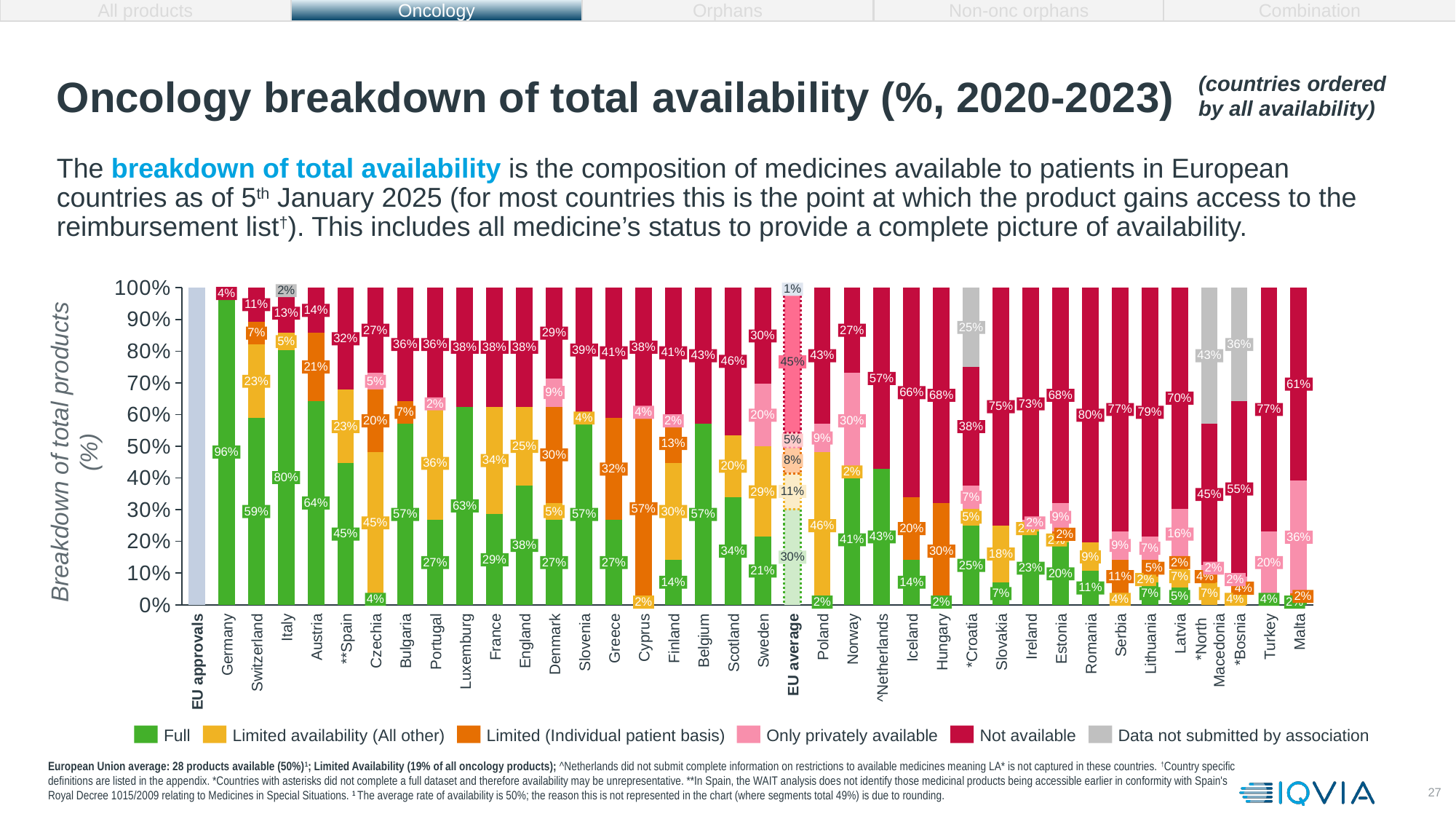
Which country has the highest 'Full' availability share? Germany What is the 'Full' availability value for Germany? 96% What kind of chart is shown on the slide? Stacked bar chart What is the 'Only privately available' value for Malta? 36% What is the 'Only privately available' value for Sweden? 20% What is the difference between the 'Full' values for Luxemburg and France? 34 percentage points What is the 'Data not submitted by association' value for *Croatia? 25% What is the 'Full' value for the EU average bar? 30% What is the 'Not available' value for Romania? 80% How many series does the legend list? 6 What colour represents the 'Not available' series in the legend? Red Which has a larger 'Not available' share, Belgium or Scotland? Scotland